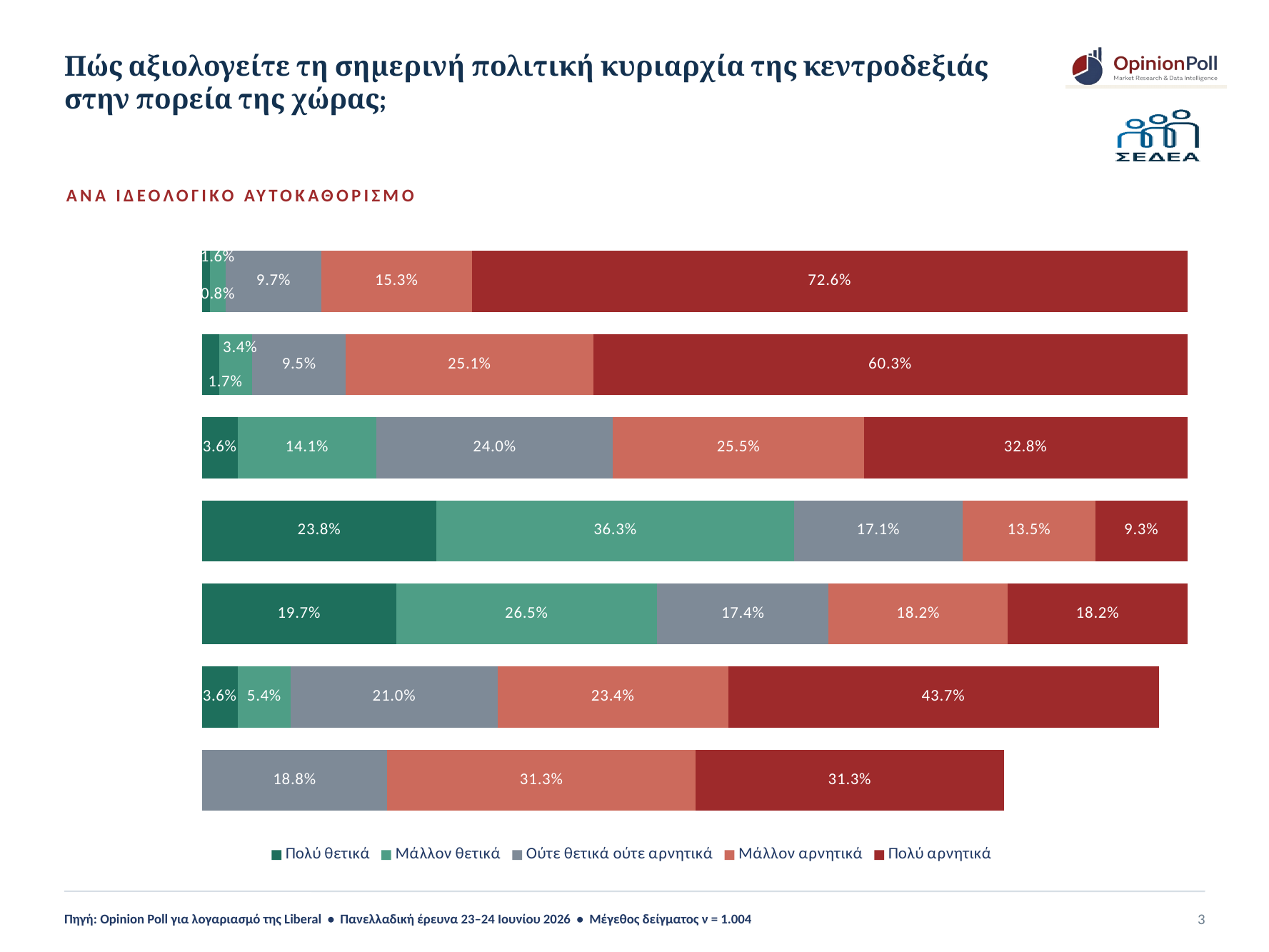
Which bar has the highest value for 'Πολύ θετικά'? The fourth bar from the top (23.8%) How many bars are plotted in the chart? 7 In the top bar, what is the value for 'Πολύ αρνητικά'? 72.6% What is the difference between the 'Πολύ αρνητικά' values of the top bar and the second bar from the top? 12.3% How many series does the legend list? 5 What kind of chart is shown on the slide? Stacked bar chart In the fourth bar from the top, what is the value for 'Μάλλον θετικά'? 36.3% In the sixth bar from the top, what is the value for 'Πολύ αρνητικά'? 43.7% In the bottom bar, what is the value for 'Ούτε θετικά ούτε αρνητικά'? 18.8% Which bar has the lowest value for 'Πολύ αρνητικά'? The fourth bar from the top (9.3%) In the fifth bar from the top, which is larger: 'Πολύ θετικά' or 'Μάλλον θετικά'? Μάλλον θετικά What is the label of the last entry in the legend? Πολύ αρνητικά